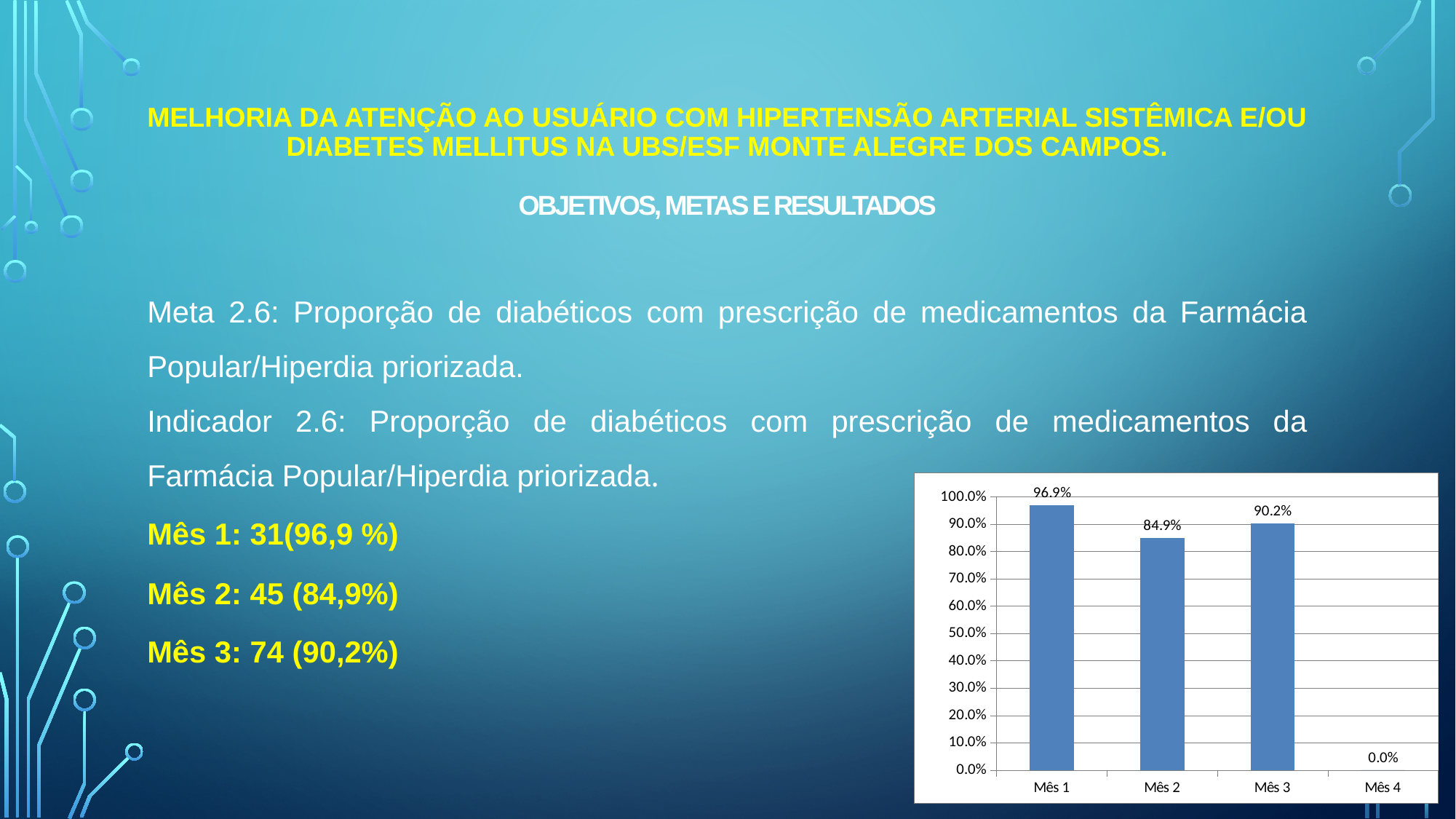
What is the value for Mês 4? 0.0% What is the difference between the values for Mês 3 and Mês 2? 5.3% Which is larger, the value for Mês 2 or the value for Mês 3? Mês 3 Is the value for Mês 2 greater or less than 80.0%? greater What is the value for Mês 2? 84.9% What is the difference between the values for Mês 1 and Mês 2? 12.0% Which category has the lowest value? Mês 4 What is the value for Mês 1? 96.9% Which category has the highest value? Mês 1 What is the value for Mês 3? 90.2% What kind of chart is shown on the slide? Bar chart How many categories are shown on the x axis of the chart? 4